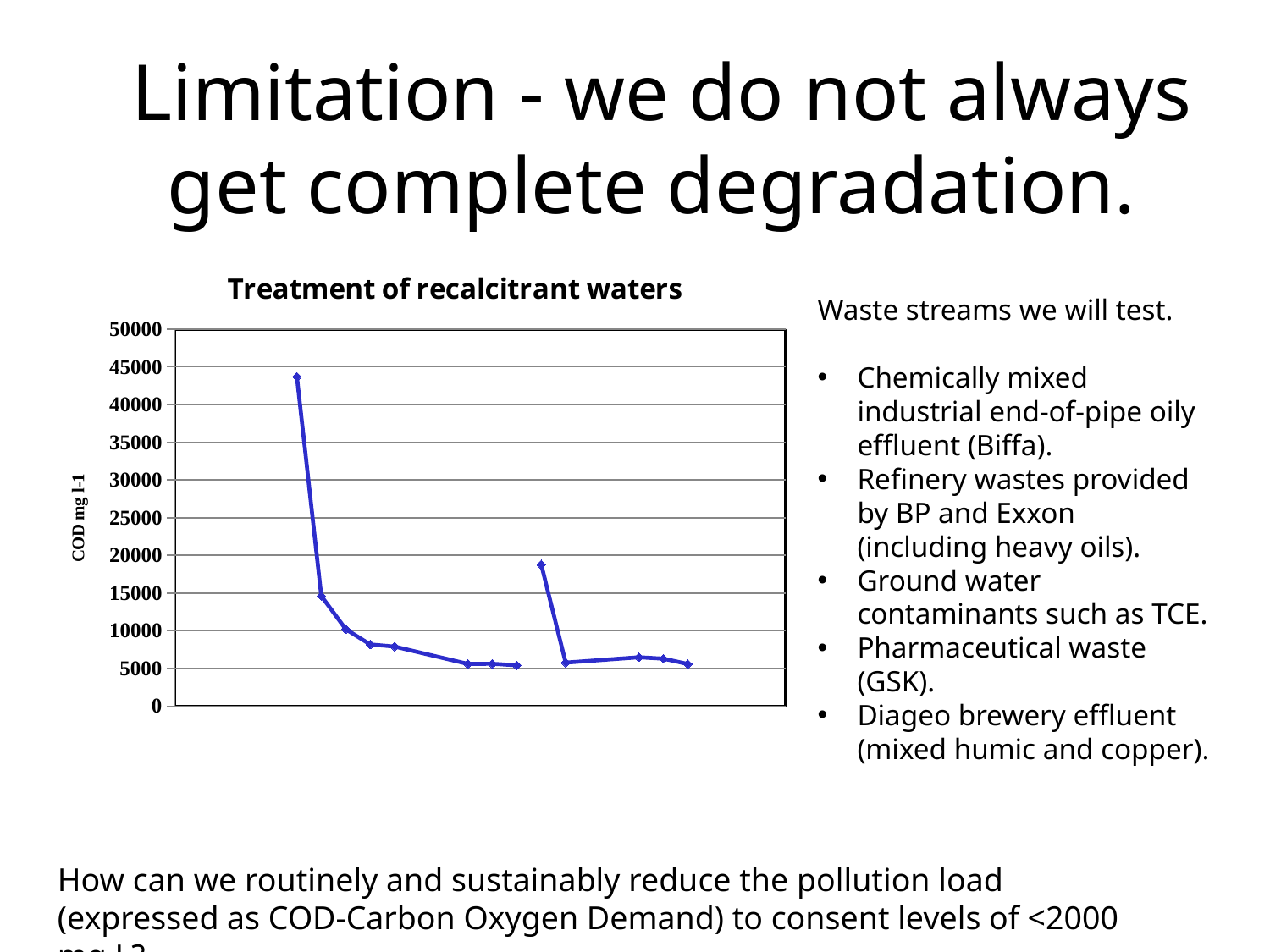
What kind of chart is shown on the slide? Line chart Is the second point of the left-hand line segment greater or less than 20000? less Is the value of the first point of the second (right-hand) line segment greater or less than 15000? greater What is the title of the chart? Treatment of recalcitrant waters How many separate line segments are plotted on the chart? 2 Is the value of the first point of the second (right-hand) line segment greater or less than 20000? less What is the label on the vertical axis of the chart? COD mg l-1 Which is larger: the first point of the left-hand line segment or the first point of the right-hand line segment? The first point of the left-hand segment Do the values in the left-hand line segment rise or fall from left to right? Fall What is the highest value shown on the vertical axis of the chart? 50000